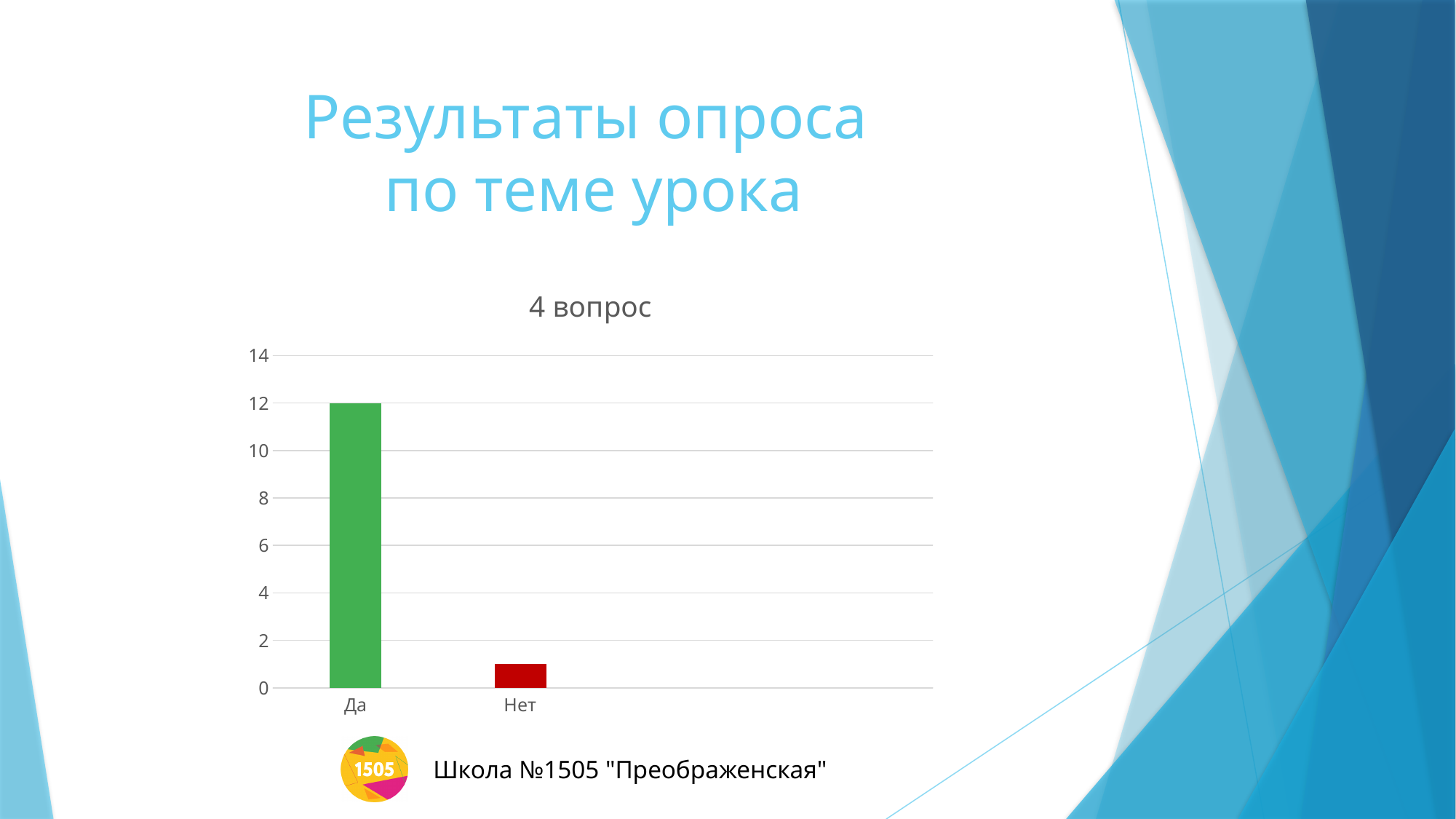
Do the values rise or fall from Да to Нет along the x axis? fall What is the value for Да? 12 Is the value for Да greater or less than 10? greater Which is larger, the value for Да or the value for Нет? Да What is the highest value shown on the y axis? 14 What is the title of the chart? 4 вопрос Is the value for Нет greater or less than 2? less How many categories are shown on the x axis of the chart? 2 Which category has the highest value? Да Which category has the lowest value? Нет What kind of chart is shown on the slide? bar chart